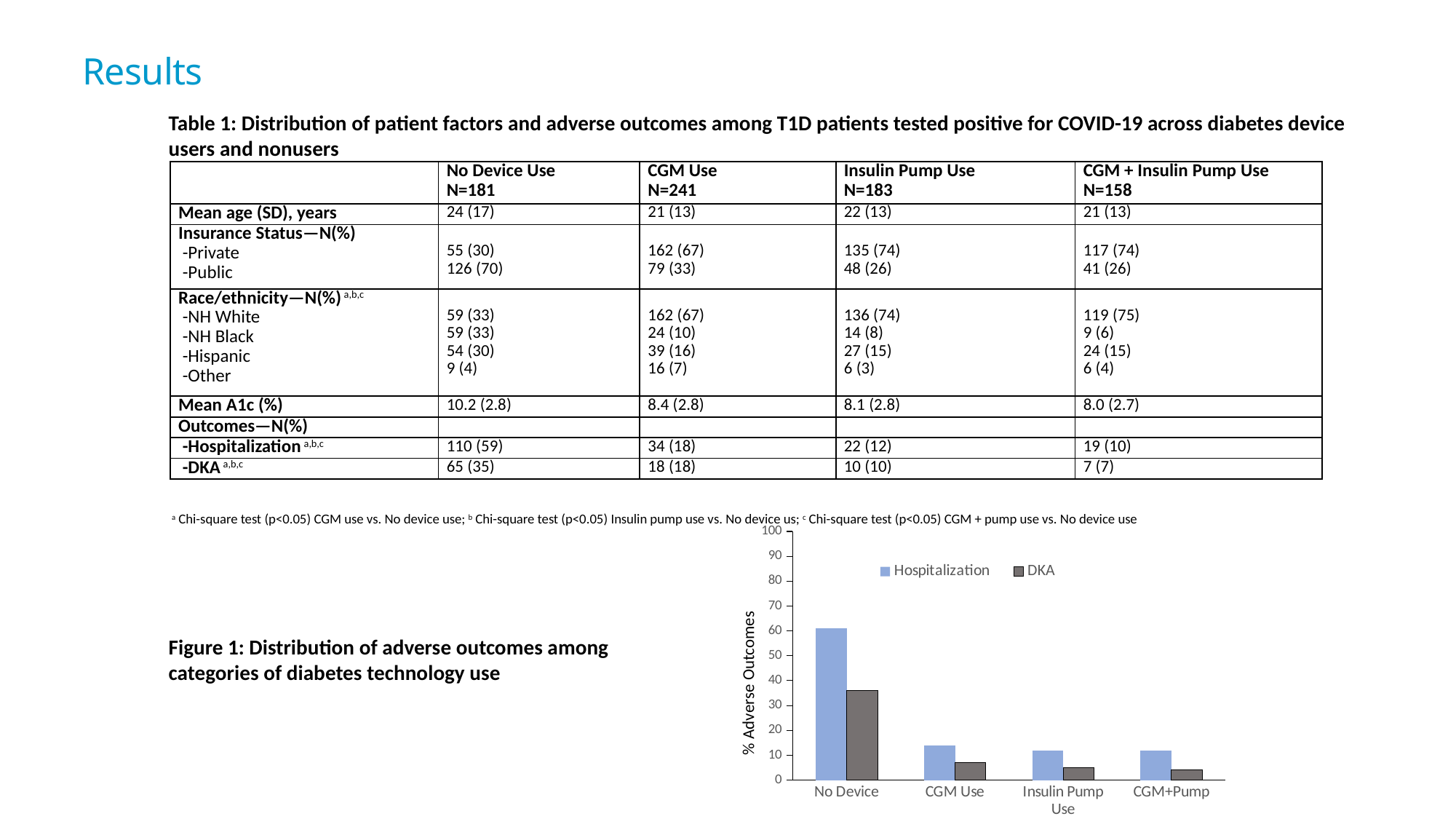
In Figure 1, is the Hospitalization value for No Device greater or less than 50? greater In Figure 1, which category has the lowest DKA value? CGM+Pump In Figure 1, do the Hospitalization values rise or fall from No Device to CGM Use? fall In Figure 1, which category has the highest DKA value? No Device How many categories are shown on the x axis of Figure 1? 4 What is the y-axis label of Figure 1? % Adverse Outcomes In Figure 1, which category has the highest Hospitalization value? No Device In Figure 1, which is larger for No Device: Hospitalization or DKA? Hospitalization What kind of chart is Figure 1? bar chart In Figure 1, is the DKA value for No Device greater or less than 40? less How many series does the legend of Figure 1 list? 2 In Figure 1, is the Hospitalization value for CGM Use greater or less than 20? less